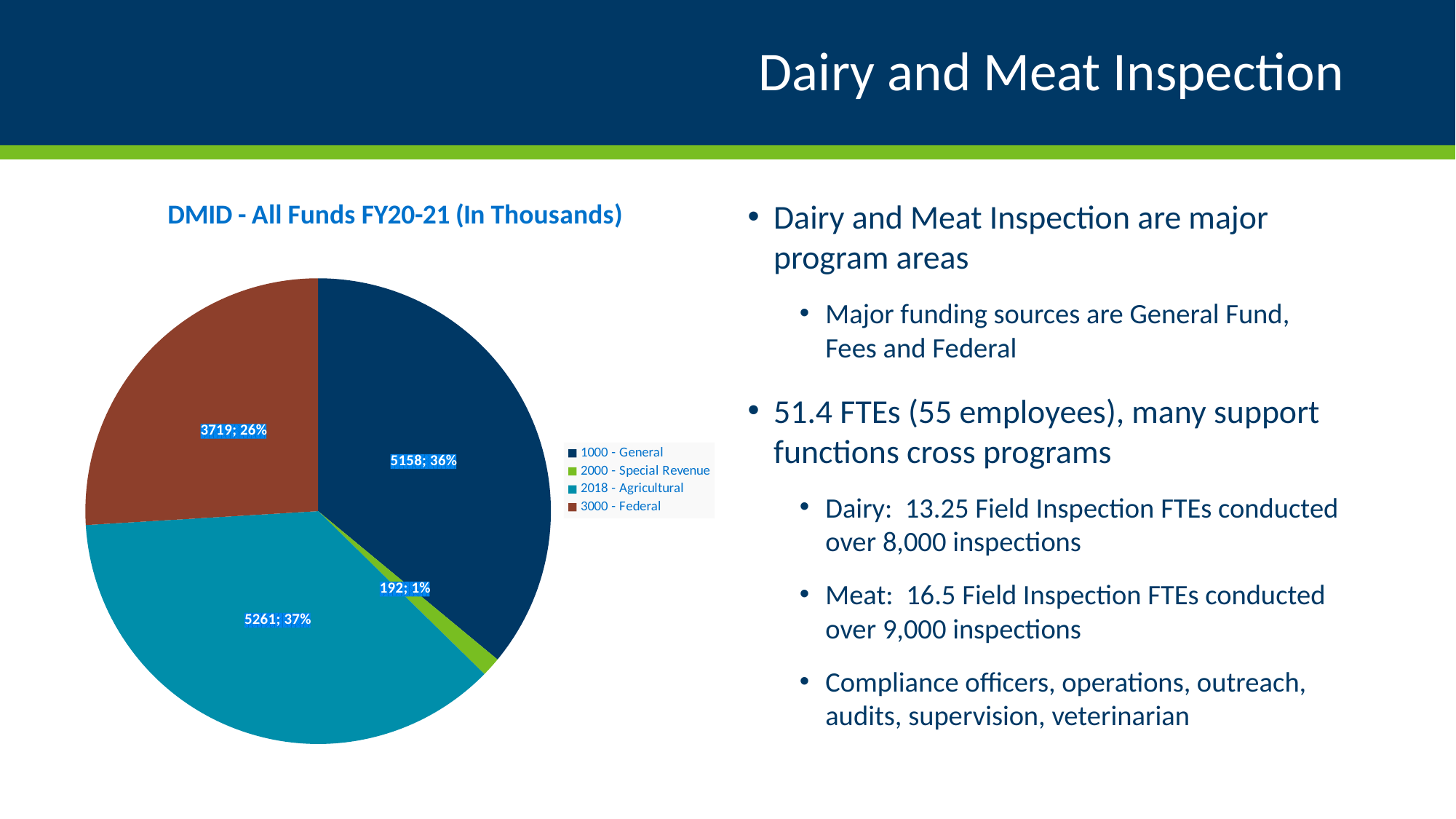
What is the value for 1000 - General in the pie chart? 5158 Which is larger, the value for 3000 - Federal or the value for 2000 - Special Revenue? 3000 - Federal Which category has the largest slice in the pie chart? 2018 - Agricultural What is the value for 2000 - Special Revenue in the pie chart? 192 Which category has the smallest slice in the pie chart? 2000 - Special Revenue What percentage share does 3000 - Federal have in the pie chart? 26% What percentage share does 1000 - General have in the pie chart? 36% What is the difference between the values for 1000 - General and 3000 - Federal? 1439 What is the title of the chart? DMID - All Funds FY20-21 (In Thousands) What type of chart is shown on the slide? Pie chart What is the value for 2018 - Agricultural in the pie chart? 5261 How many categories does the pie chart show? 4